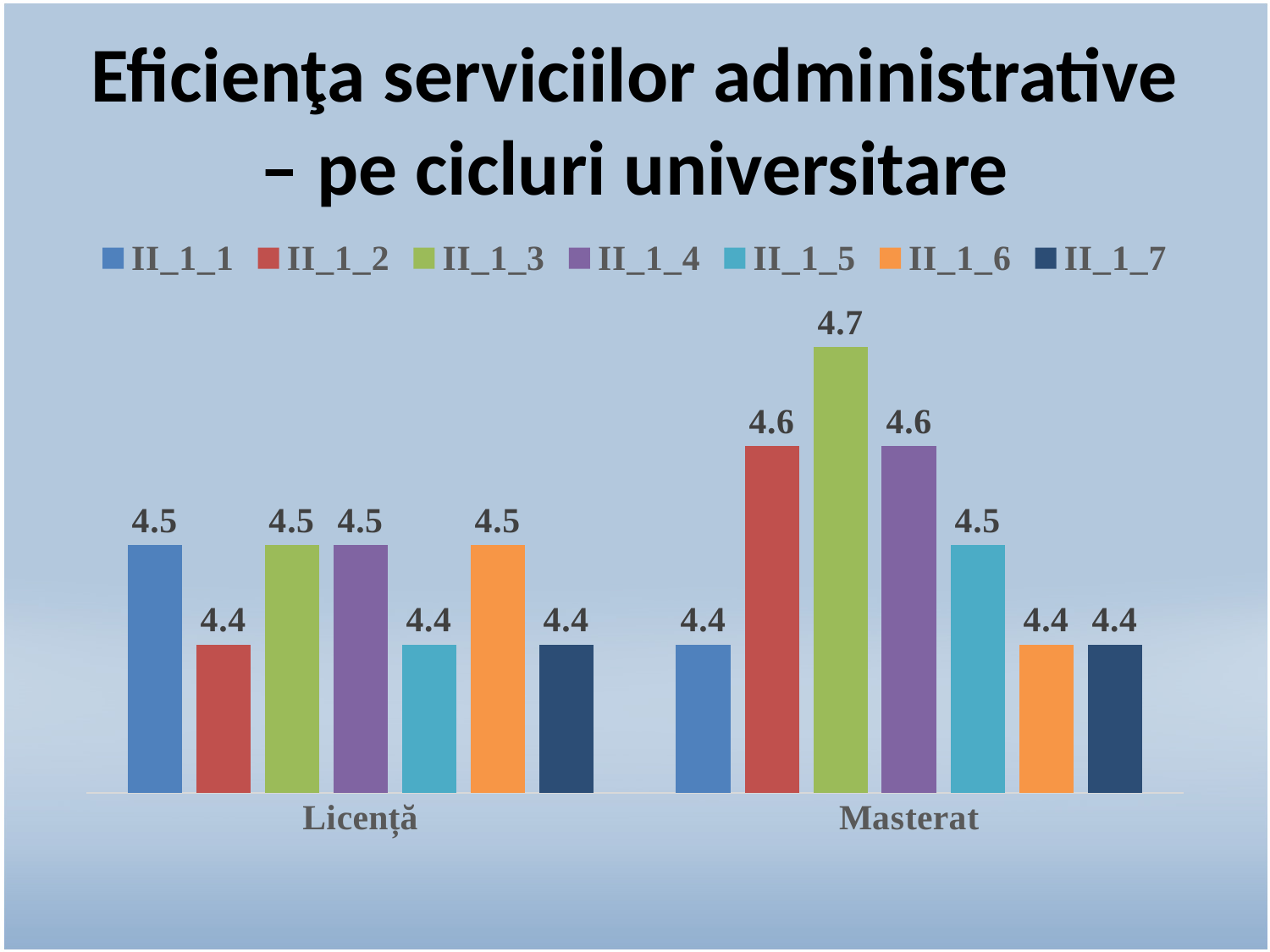
What is the value of II_1_2 for Licență? 4.4 Which is larger: the II_1_6 value for Licență or the II_1_6 value for Masterat? Licență Which is larger: the II_1_4 value for Masterat or the II_1_4 value for Licență? Masterat Which series has the highest value for Masterat? II_1_3 What is the difference between the II_1_3 value for Masterat and the II_1_3 value for Licență? 0.2 What kind of chart is shown on the slide? Bar chart What is the value of II_1_1 for Licență? 4.5 What is the value of II_1_3 for Masterat? 4.7 What is the value of II_1_6 for Masterat? 4.4 How many categories are shown on the x axis? 2 How many series does the legend list? 7 What is the difference between the II_1_2 value for Masterat and the II_1_2 value for Licență? 0.2